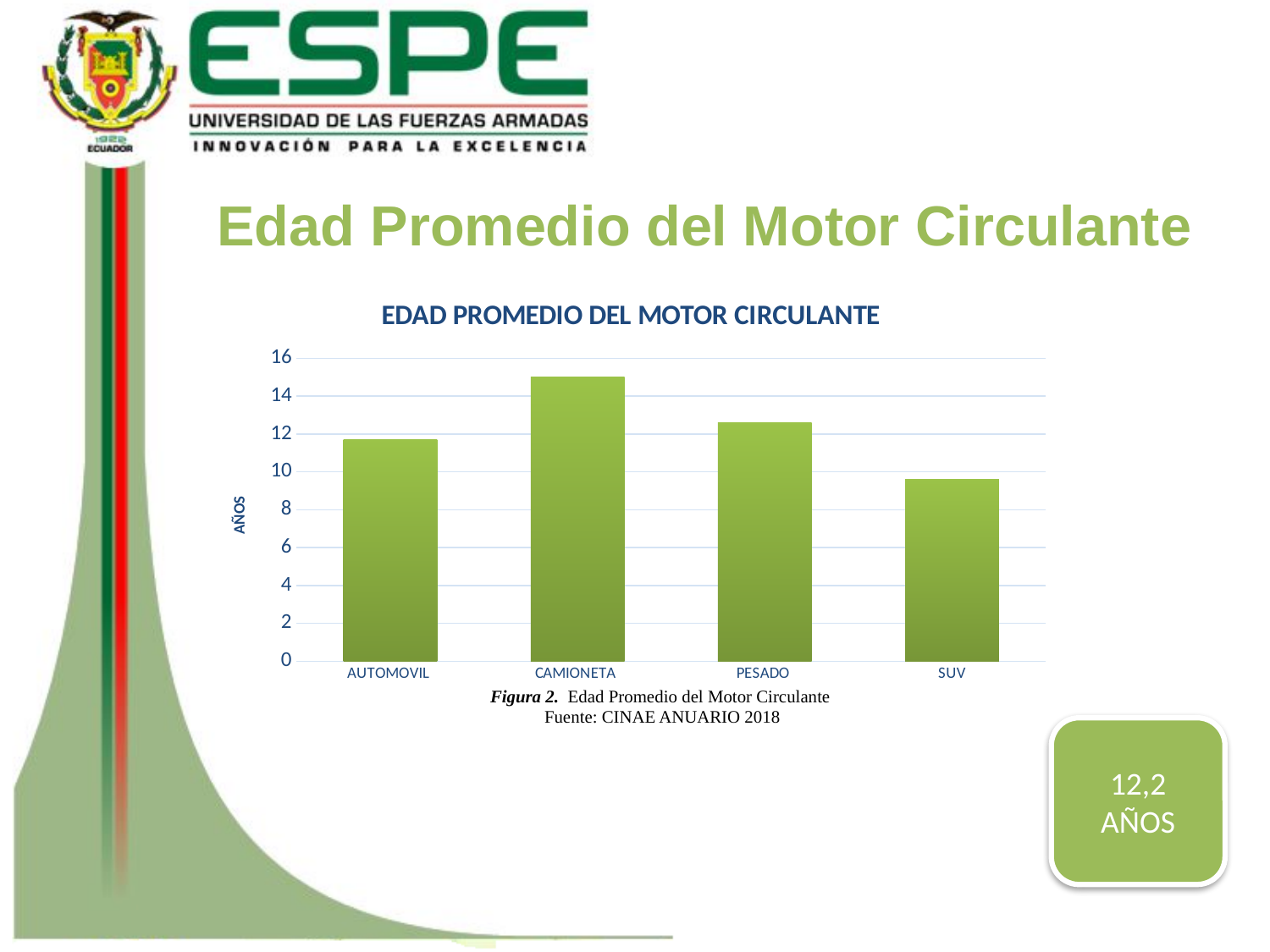
How many categories are shown on the x axis of the chart? 4 What kind of chart is shown on the slide? bar chart Is the value for PESADO greater or less than 12? greater What is the label on the vertical axis of the chart? AÑOS Which has a higher value, CAMIONETA or PESADO? CAMIONETA What is the title of the chart? EDAD PROMEDIO DEL MOTOR CIRCULANTE Which has a higher value, AUTOMOVIL or SUV? AUTOMOVIL Is the value for CAMIONETA greater or less than 14? greater Which category has the highest average engine age in the chart? CAMIONETA Is the value for AUTOMOVIL greater or less than 10? greater Which category has the lowest average engine age in the chart? SUV